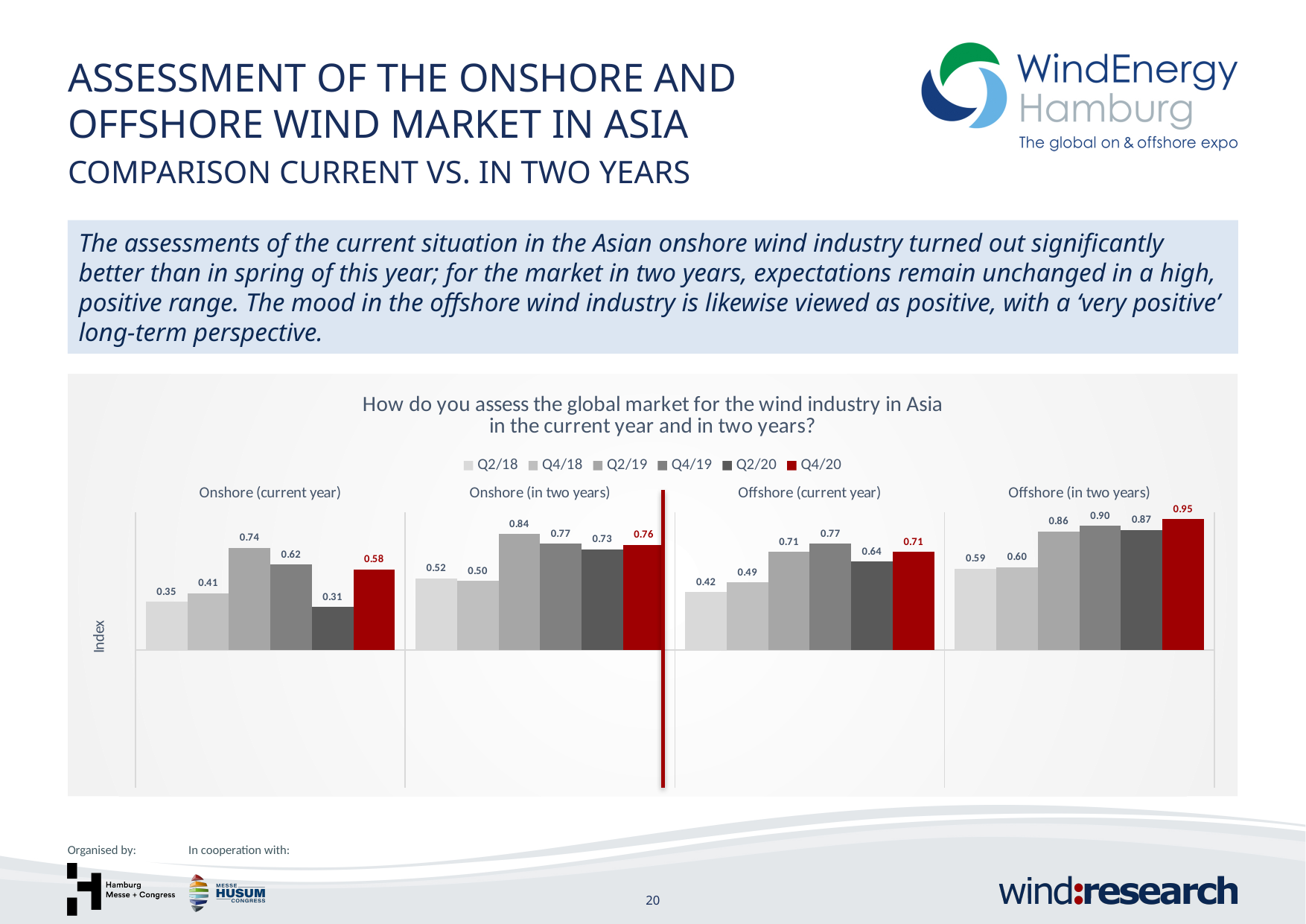
What kind of chart is shown on the slide? Bar chart Which is larger: the Q4/19 value for Offshore (current year) or the Q4/19 value for Onshore (current year)? Offshore (current year) How many category groups are shown in the chart? 4 What is the Q2/19 value for Onshore (in two years)? 0.84 What is the difference between the Q4/20 and Q2/20 values for Onshore (current year)? 0.27 Which series has the lowest value in the Onshore (current year) group? Q2/20 Which series is shown in red in the chart? Q4/20 How many series does the legend list? 6 Do the values in the Offshore (in two years) group generally rise or fall from Q2/18 to Q4/20? Rise Which series has the highest value in the Offshore (in two years) group? Q4/20 What is the Q4/20 value for Onshore (current year)? 0.58 What is the Q2/18 value for Offshore (current year)? 0.42